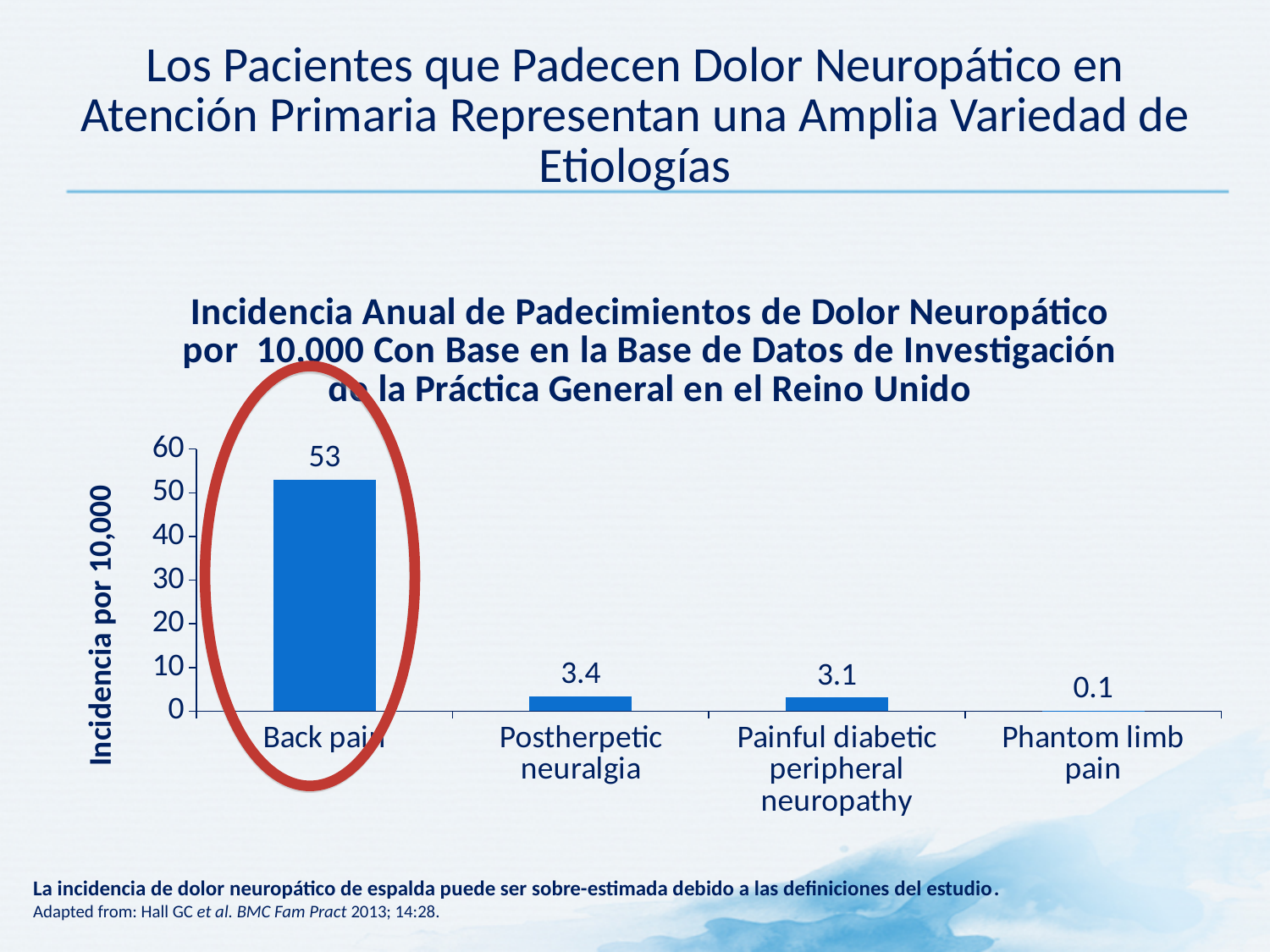
Which condition has the lowest incidence? Phantom limb pain What is the incidence per 10,000 for Phantom limb pain? 0.1 Which condition has the highest incidence? Back pain What is the incidence per 10,000 for Postherpetic neuralgia? 3.4 Which has a higher incidence, Back pain or Phantom limb pain? Back pain What type of chart is shown on the slide? Bar chart Is the value for Back pain greater or less than 50? greater What is the incidence per 10,000 for Back pain? 53 What is the incidence per 10,000 for Painful diabetic peripheral neuropathy? 3.1 How many conditions are shown on the chart? 4 What is the difference in incidence between Back pain and Postherpetic neuralgia? 49.6 What is the difference in incidence between Postherpetic neuralgia and Painful diabetic peripheral neuropathy? 0.3